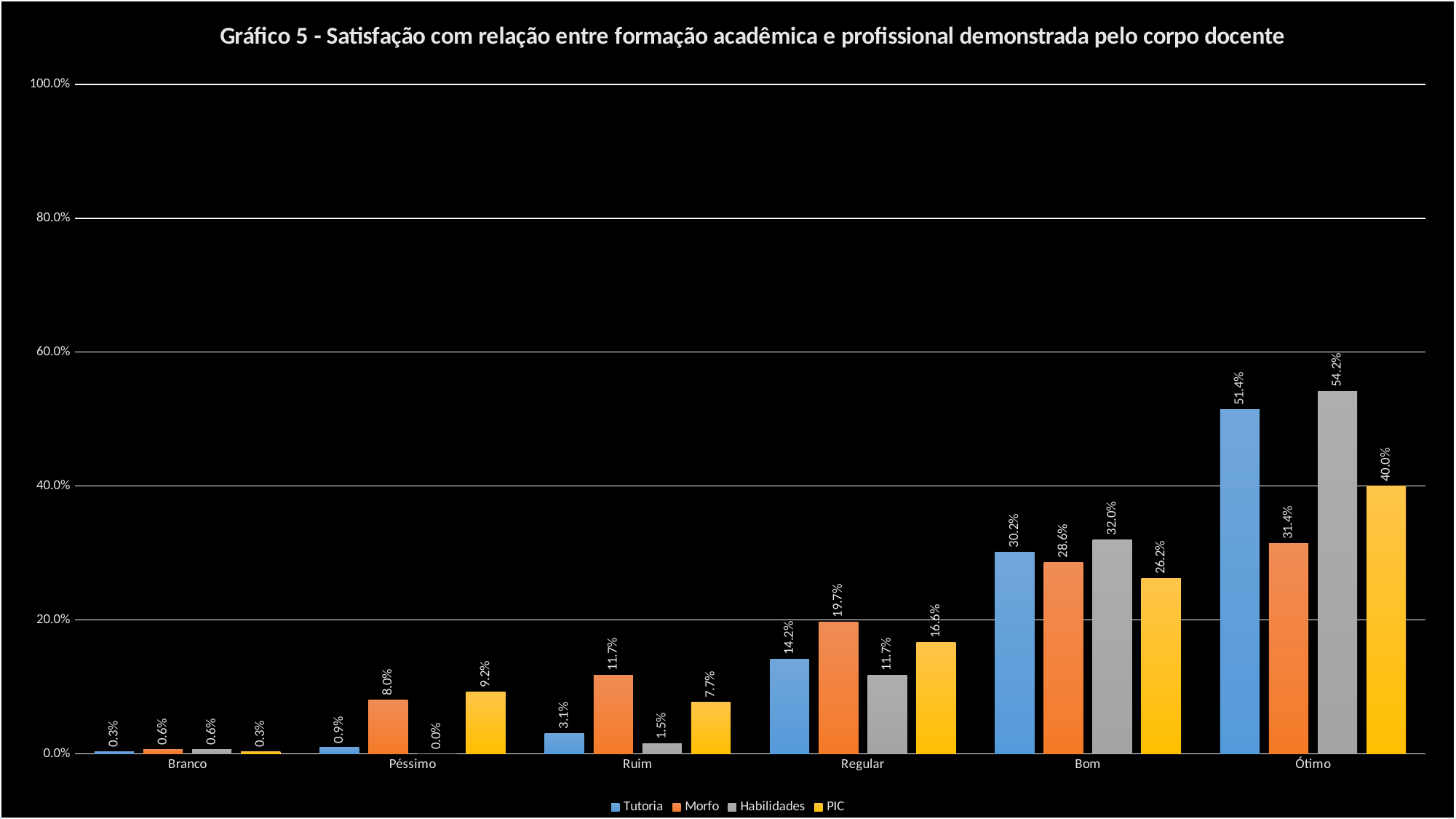
How many series does the legend list? 4 What kind of chart is shown on the slide? Bar chart Is the value for Tutoria in the Ótimo category greater or less than 40.0%? greater What is the value for PIC in the Péssimo category? 9.2% What is the value for Habilidades in the Ótimo category? 54.2% Which series has the lowest value in the Péssimo category? Habilidades Which is larger in the Bom category: Habilidades or PIC? Habilidades Which series has the highest value in the Ótimo category? Habilidades What is the difference between the Tutoria and Morfo values in the Ótimo category? 20.0% How many categories are shown on the x axis? 6 What is the value for Morfo in the Regular category? 19.7% What is the value for Tutoria in the Bom category? 30.2%